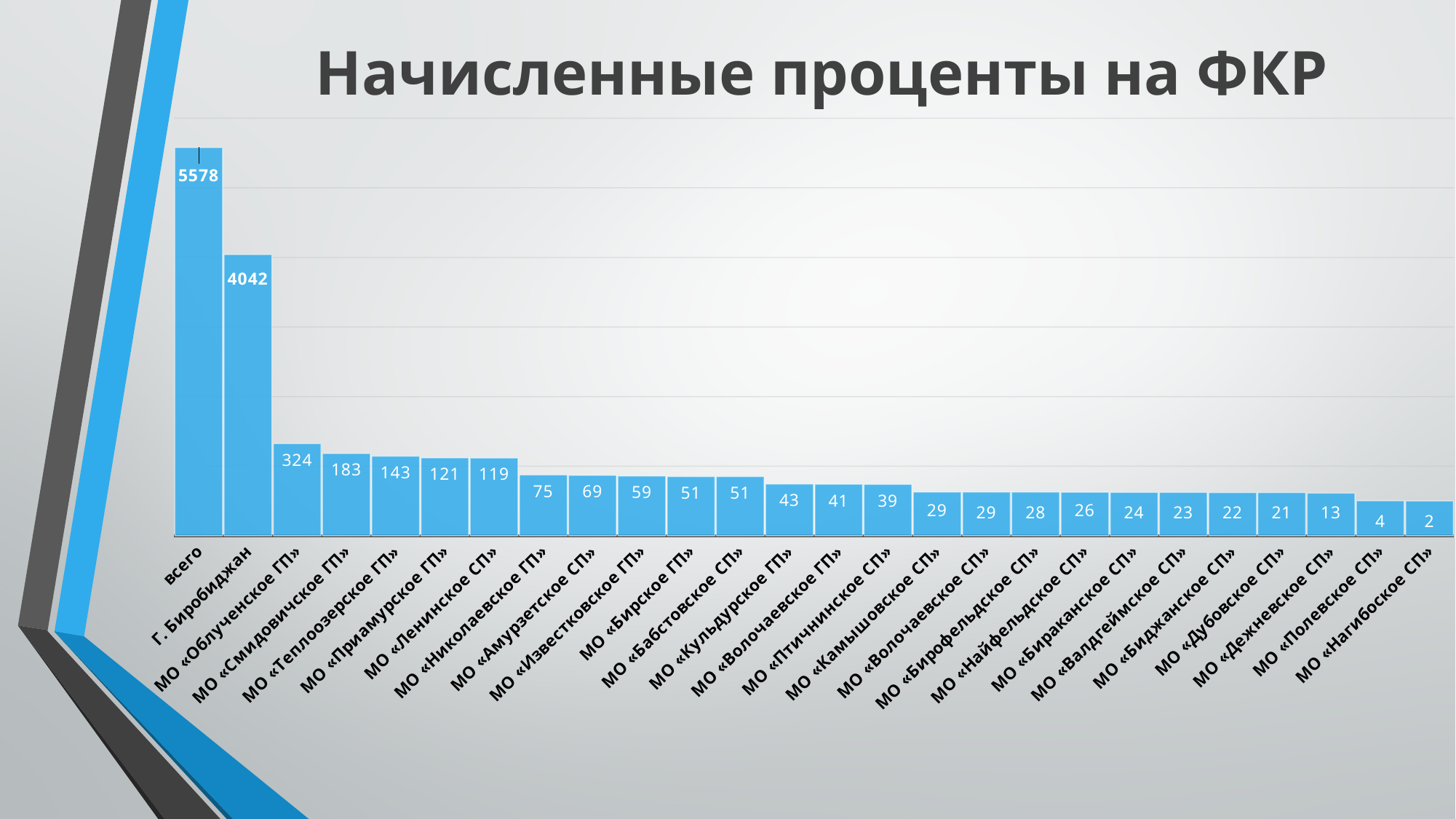
What is the difference between the values for всего and г. Биробиджан? 1536 Which category has the highest value? всего What is the value for МО «Дежневское СП»? 13 What is the value for МО «Облученское ГП»? 324 What is the title of the chart? Начисленные проценты на ФКР How many categories are shown on the chart? 26 Which is larger, the value for МО «Николаевское ГП» or МО «Амурзетское СП»? МО «Николаевское ГП» What kind of chart is shown on the slide? bar chart What is the value for МО «Ленинское СП»? 119 What is the value for г. Биробиджан? 4042 Which category has the lowest value? МО «Нагибоское СП» What is the difference between the values for МО «Смидовичское ГП» and МО «Теплоозерское ГП»? 40